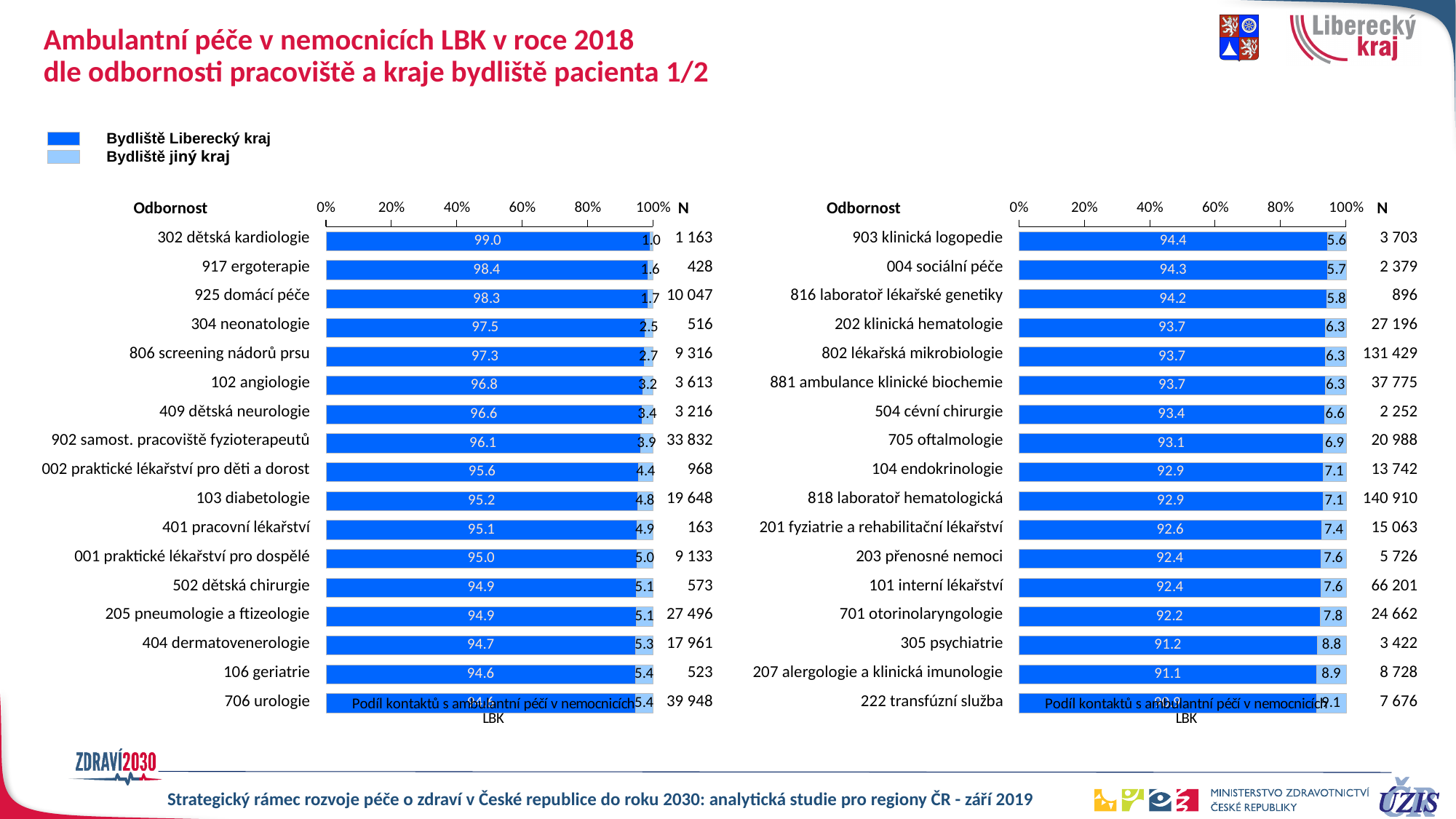
In the right chart, which category has the highest value for Bydliště Liberecký kraj? 903 klinická logopedie In the left chart, what is the value for Bydliště jiný kraj for 103 diabetologie? 4.8 In the left chart, what is the N value for 925 domácí péče? 10 047 In the left chart, what is the difference between the Bydliště Liberecký kraj values for 917 ergoterapie and 304 neonatologie? 0.9 In the right chart, what is the N value for 818 laboratoř hematologická? 140 910 In the left chart, which category has the highest value for Bydliště Liberecký kraj? 302 dětská kardiologie In the right chart, which is larger for Bydliště jiný kraj: 207 alergologie a klinická imunologie or 104 endokrinologie? 207 alergologie a klinická imunologie How many series does the legend list? 2 What kind of chart is shown on the left side of the slide? Stacked horizontal bar chart In the right chart, what is the value for Bydliště Liberecký kraj for 305 psychiatrie? 91.2 In the left chart, what is the value for Bydliště Liberecký kraj for 302 dětská kardiologie? 99.0 In the right chart, what is the value for Bydliště jiný kraj for 705 oftalmologie? 6.9